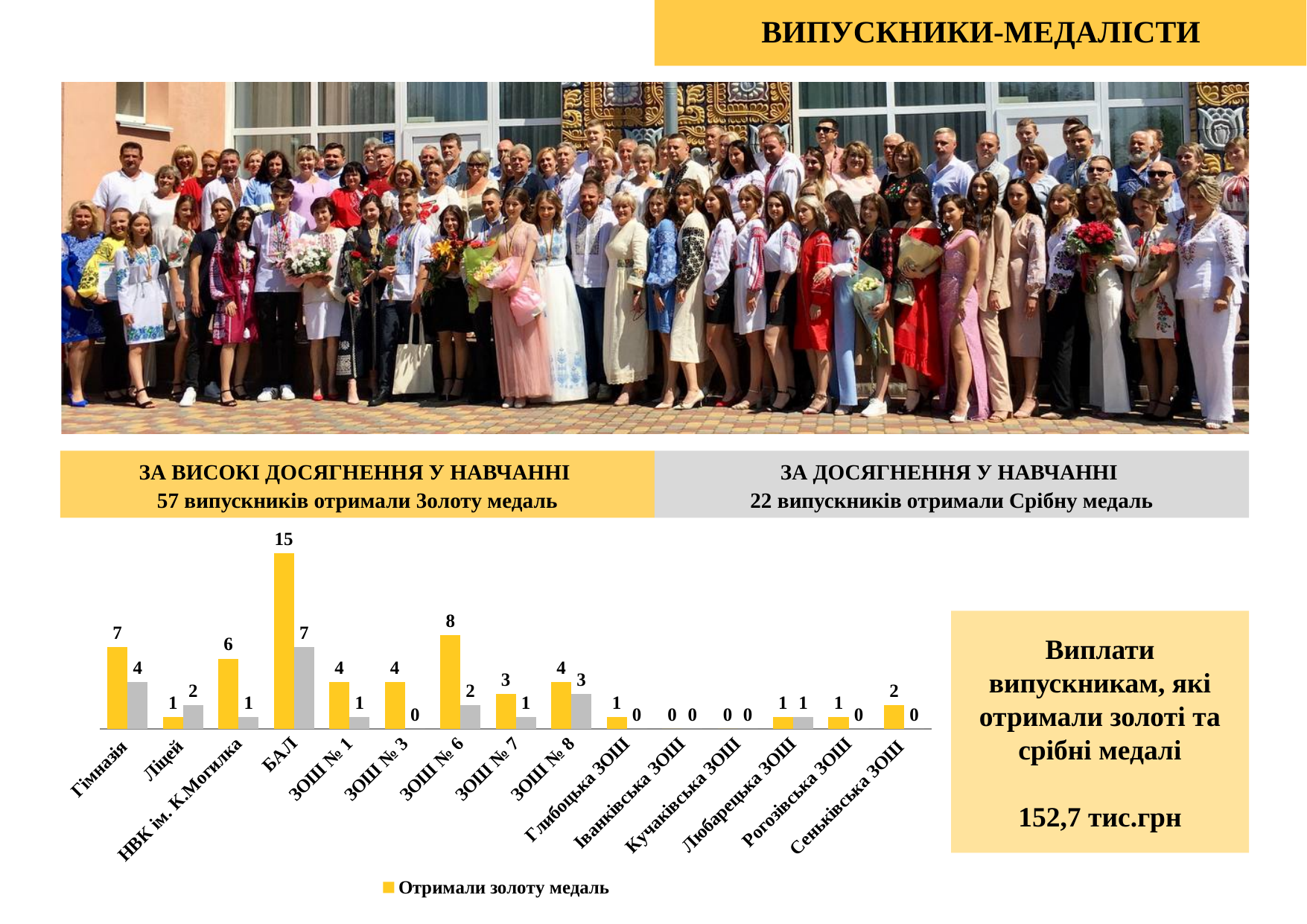
What is the value of the yellow bar for Гімназія? 7 What type of chart is shown on the slide? Bar chart What is the difference between the yellow bars for Гімназія and Ліцей? 6 Which school has the highest number of gold medals (yellow bar) on the chart? БАЛ How many schools (categories) are shown on the x axis of the chart? 15 What is the difference between the yellow bar and the gray bar for БАЛ? 8 What is the value of the yellow bar for ЗОШ № 6? 8 What is the value of the gray bar for ЗОШ № 8? 3 What is the value of the gray bar for Гімназія? 4 How many series does the chart legend list? 1 Which has the larger yellow bar: Гімназія or ЗОШ № 6? ЗОШ № 6 How many graduates of БАЛ received a gold medal according to the chart? 15